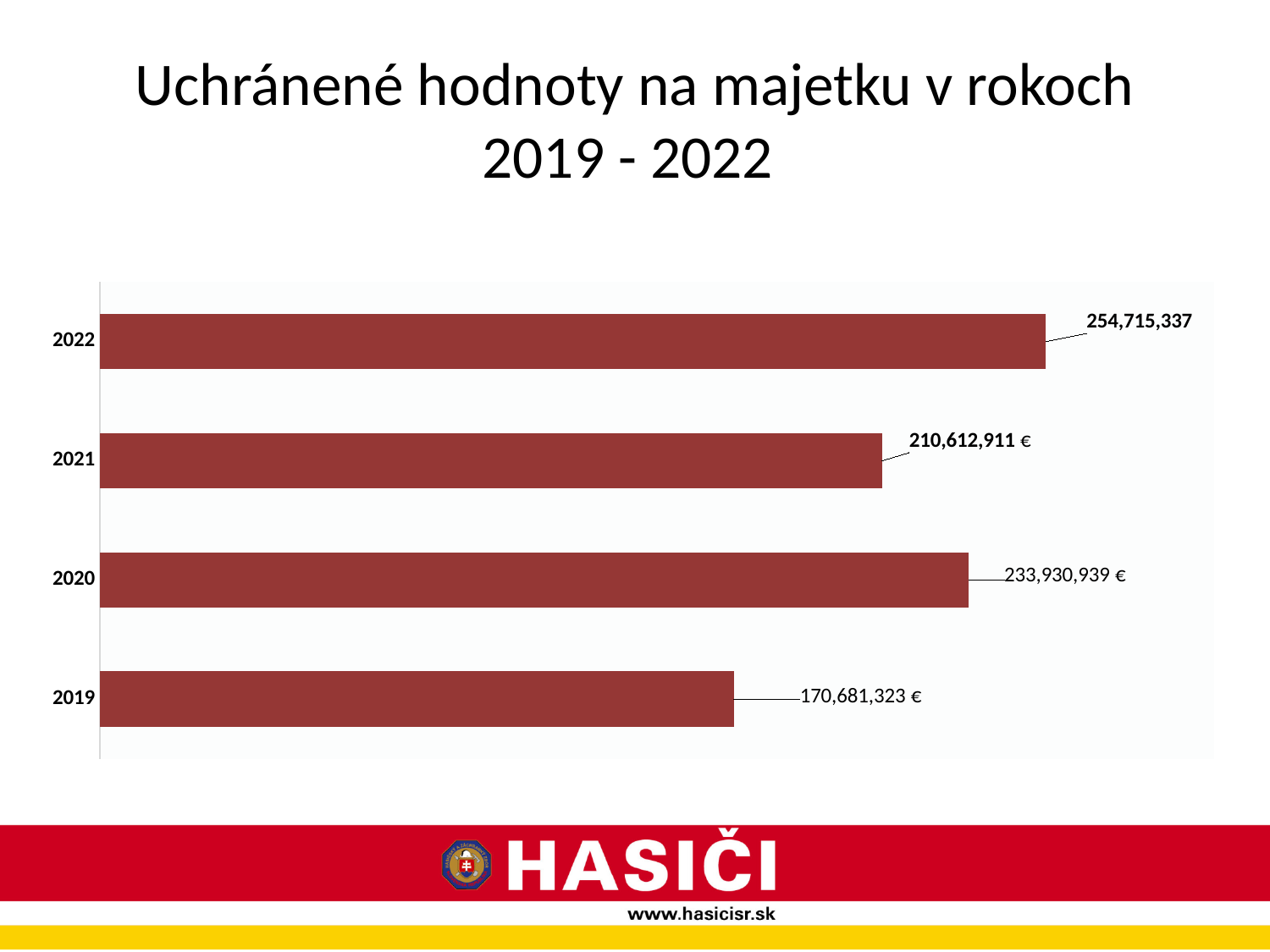
How many years are shown in the chart? 4 Which year has the highest value? 2022 Which year has the lowest value? 2019 What is the value for 2019? 170,681,323 € What is the value for 2020? 233,930,939 € What is the value for 2022? 254,715,337 What is the value for 2021? 210,612,911 € What is the difference between the values for 2020 and 2019? 63,249,616 € What is the difference between the values for 2022 and 2021? 44,102,426 What kind of chart is shown on the slide? Bar chart Which is larger, the value for 2020 or the value for 2021? 2020 What is the title of the slide? Uchránené hodnoty na majetku v rokoch 2019 - 2022